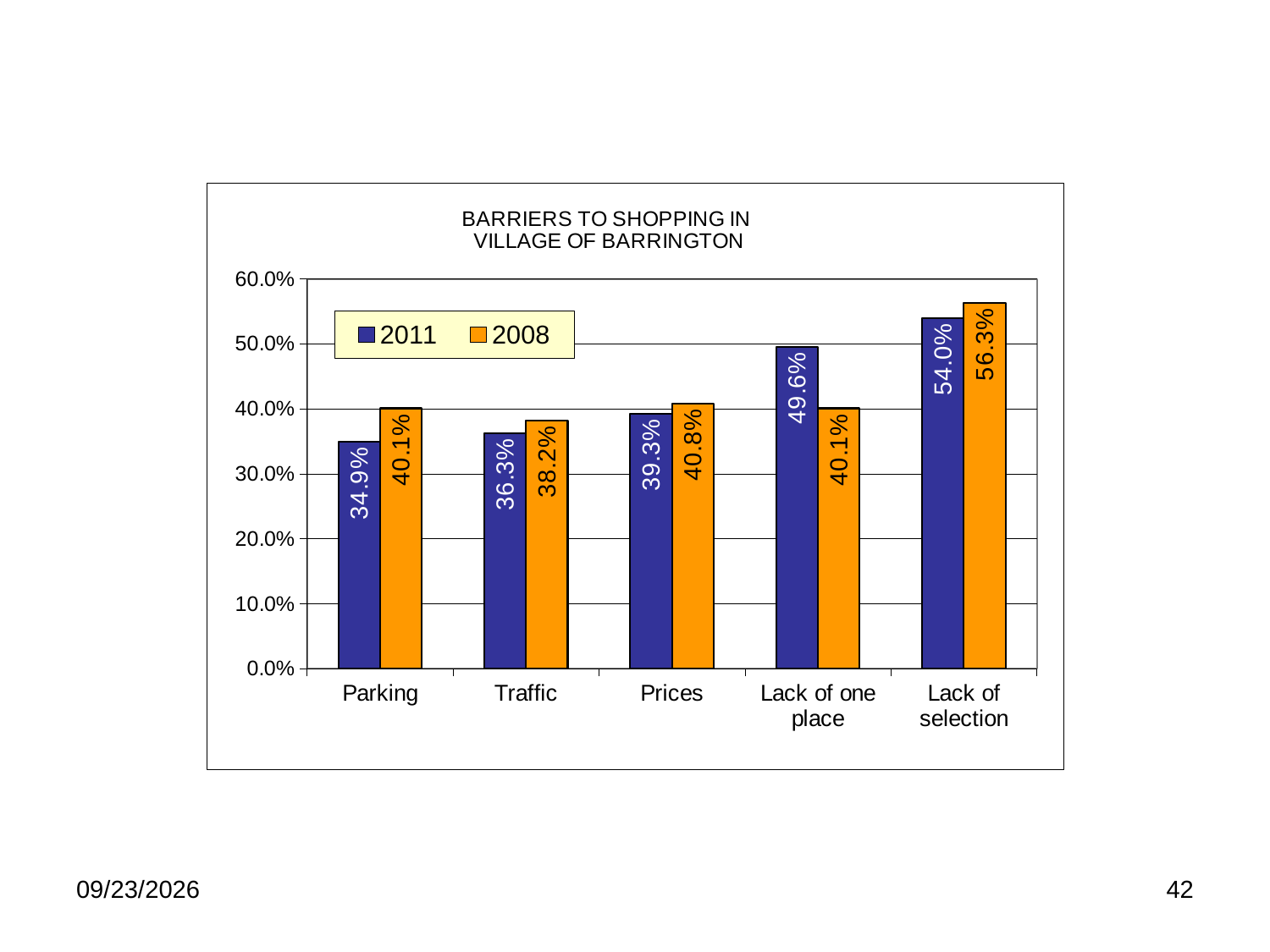
What is the 2011 value for Parking? 34.9% How many categories are shown on the x axis? 5 Which category has the lowest 2008 value? Traffic Is the 2011 value for Lack of one place greater or less than 40.0%? greater Which is larger for Prices, the 2011 value or the 2008 value? 2008 Which category has the highest 2011 value? Lack of selection What kind of chart is shown? bar chart What is the title of the chart? BARRIERS TO SHOPPING IN VILLAGE OF BARRINGTON What is the difference between the 2008 and 2011 values for Lack of one place? 9.5% How many series does the legend list? 2 What is the 2008 value for Lack of selection? 56.3% What is the 2011 value for Lack of one place? 49.6%